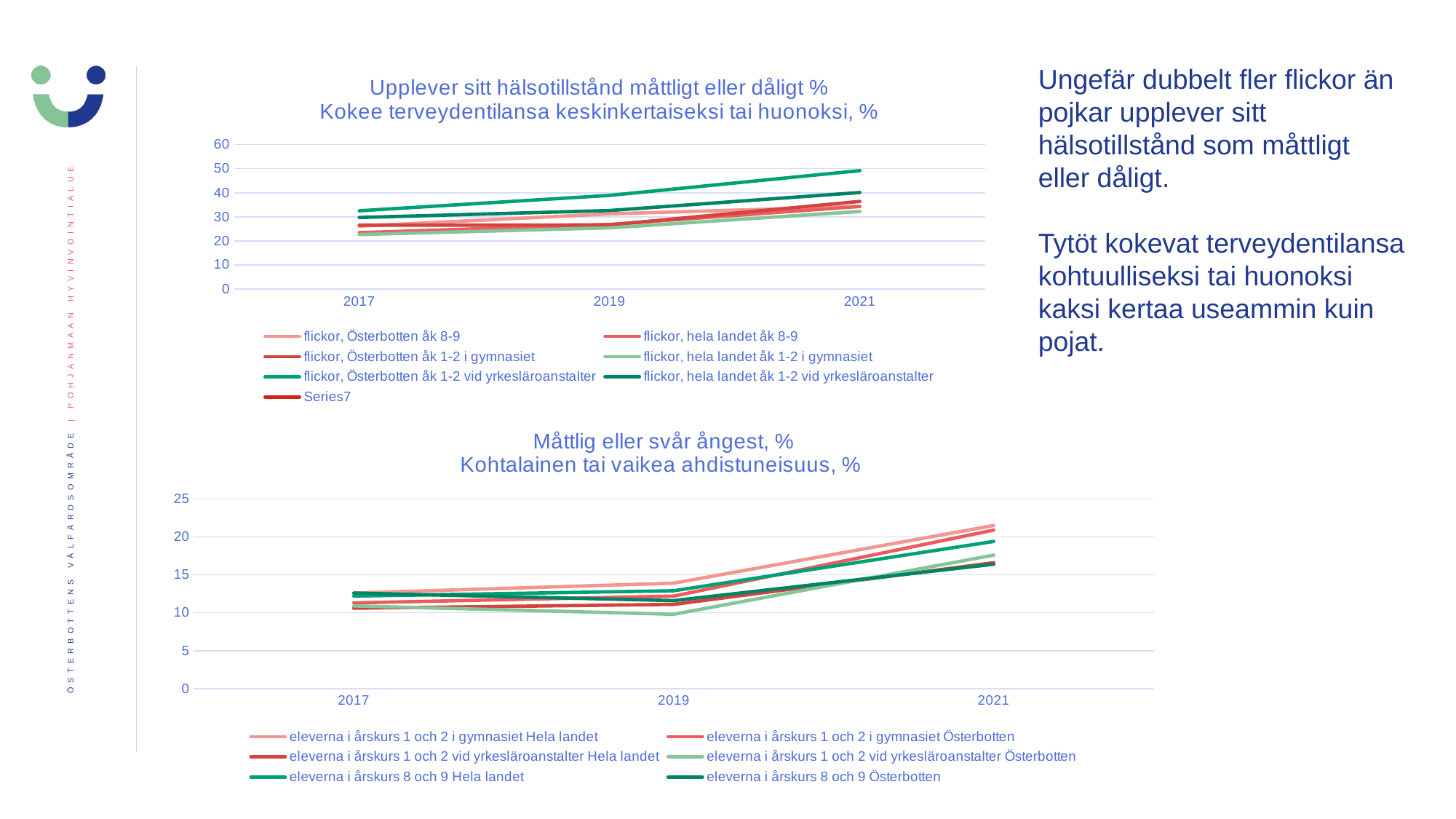
How many years are shown on the x axis of the top chart 'Upplever sitt hälsotillstånd måttligt eller dåligt %'? 3 How many years are shown on the x axis of the bottom chart 'Måttlig eller svår ångest, %'? 3 In the bottom chart 'Måttlig eller svår ångest, %', is the 2021 value for 'eleverna i årskurs 8 och 9 Österbotten' greater or less than 20? less In the top chart 'Upplever sitt hälsotillstånd måttligt eller dåligt %', does the line for 'flickor, Österbotten åk 1-2 vid yrkesläroanstalter' rise or fall from 2017 to 2021? rise In the top chart 'Upplever sitt hälsotillstånd måttligt eller dåligt %', is the 2021 value for 'flickor, Österbotten åk 1-2 vid yrkesläroanstalter' greater or less than 40? greater In the bottom chart 'Måttlig eller svår ångest, %', how many series does the legend list? 6 In the top chart 'Upplever sitt hälsotillstånd måttligt eller dåligt %', is the 2017 value for 'flickor, Österbotten åk 1-2 vid yrkesläroanstalter' greater or less than 30? greater What kind of chart is the top chart titled 'Upplever sitt hälsotillstånd måttligt eller dåligt %'? line chart In the top chart 'Upplever sitt hälsotillstånd måttligt eller dåligt %', how many series does the legend list? 7 What kind of chart is the bottom chart titled 'Måttlig eller svår ångest, %'? line chart In the bottom chart 'Måttlig eller svår ångest, %', does the line for 'eleverna i årskurs 8 och 9 Hela landet' rise or fall from 2019 to 2021? rise